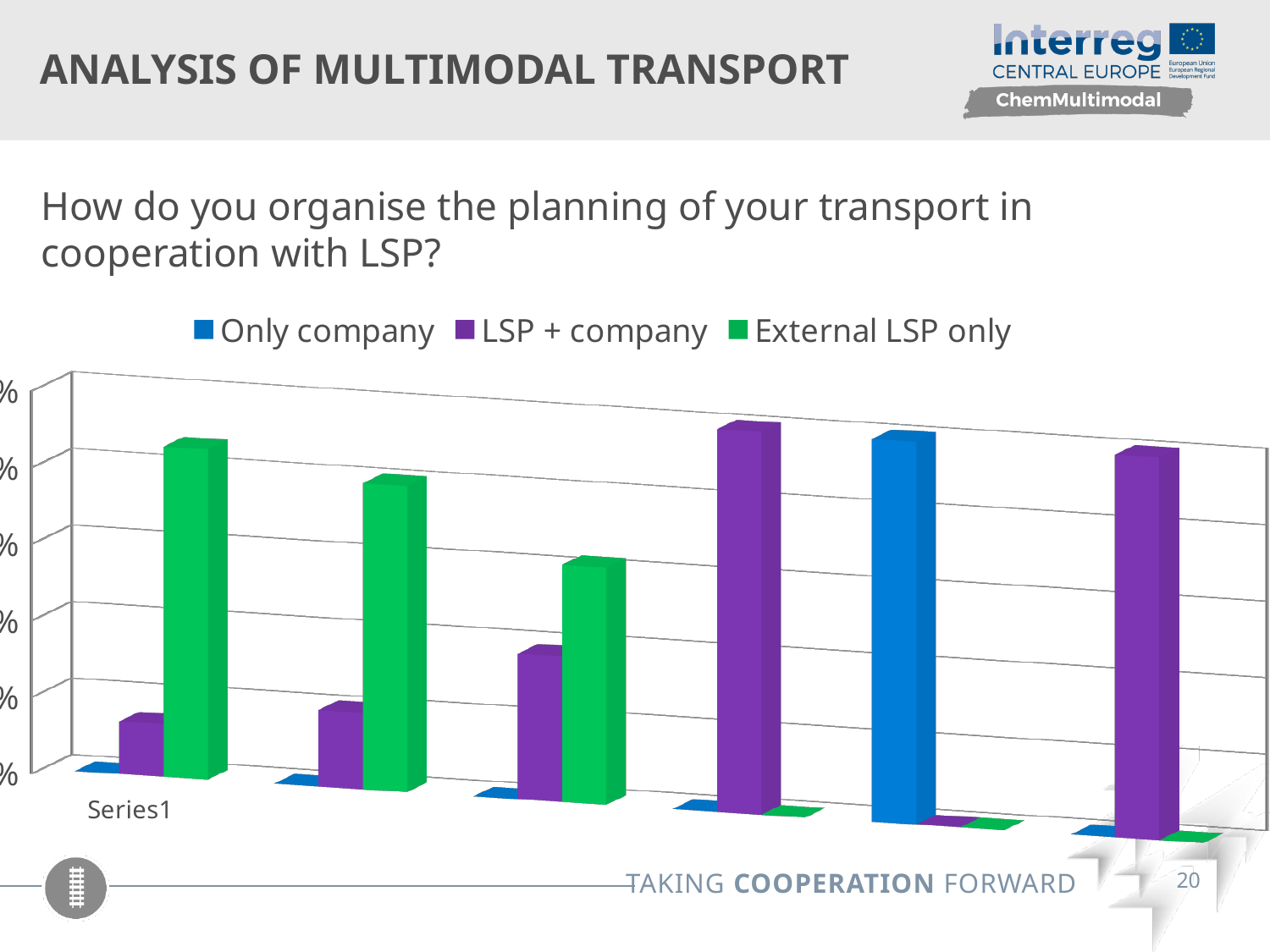
What kind of chart is shown on the slide? bar chart How many groups of bars are plotted in the chart? 6 In the Series1 group, which is larger: LSP + company or Only company? LSP + company Which series is shown in green in the chart? External LSP only In the Series1 group, which is larger: External LSP only or LSP + company? External LSP only Which series is shown in blue in the chart? Only company Which series has the lowest value in the Series1 group? Only company Which series has the highest value in the Series1 group? External LSP only How many series does the chart legend list? 3